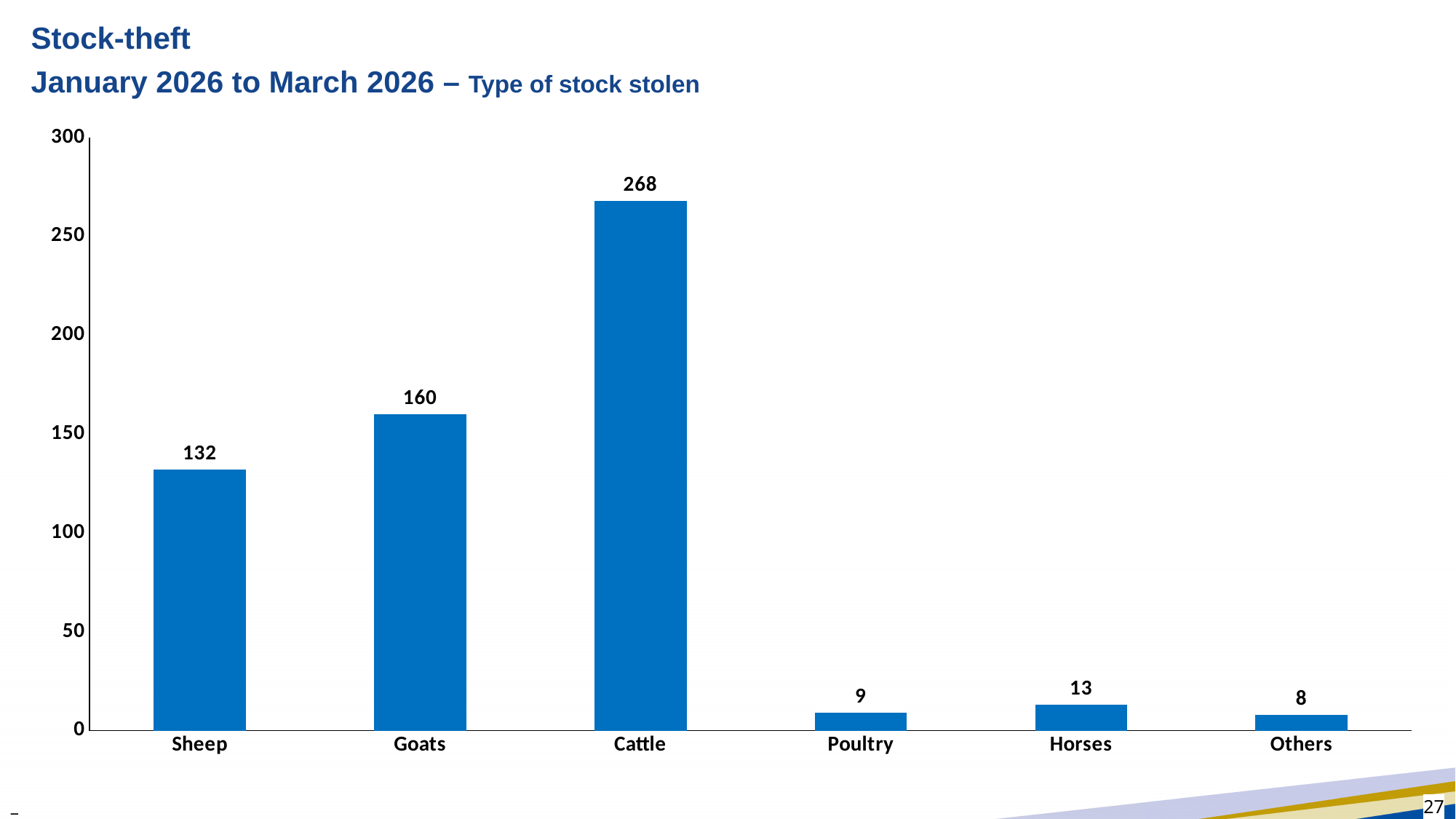
What is the value for Sheep? 132 Which type of stock has the highest value? Cattle What is the difference between the values for Goats and Sheep? 28 What period does the chart title say the data covers? January 2026 to March 2026 Which type of stock has the lowest value? Others Which is larger, the value for Goats or the value for Sheep? Goats What is the value for Horses? 13 Is the value for Cattle greater or less than 250? greater What kind of chart is shown on the slide? bar chart What is the difference between the values for Cattle and Goats? 108 What is the value for Cattle? 268 How many categories are shown on the x axis? 6